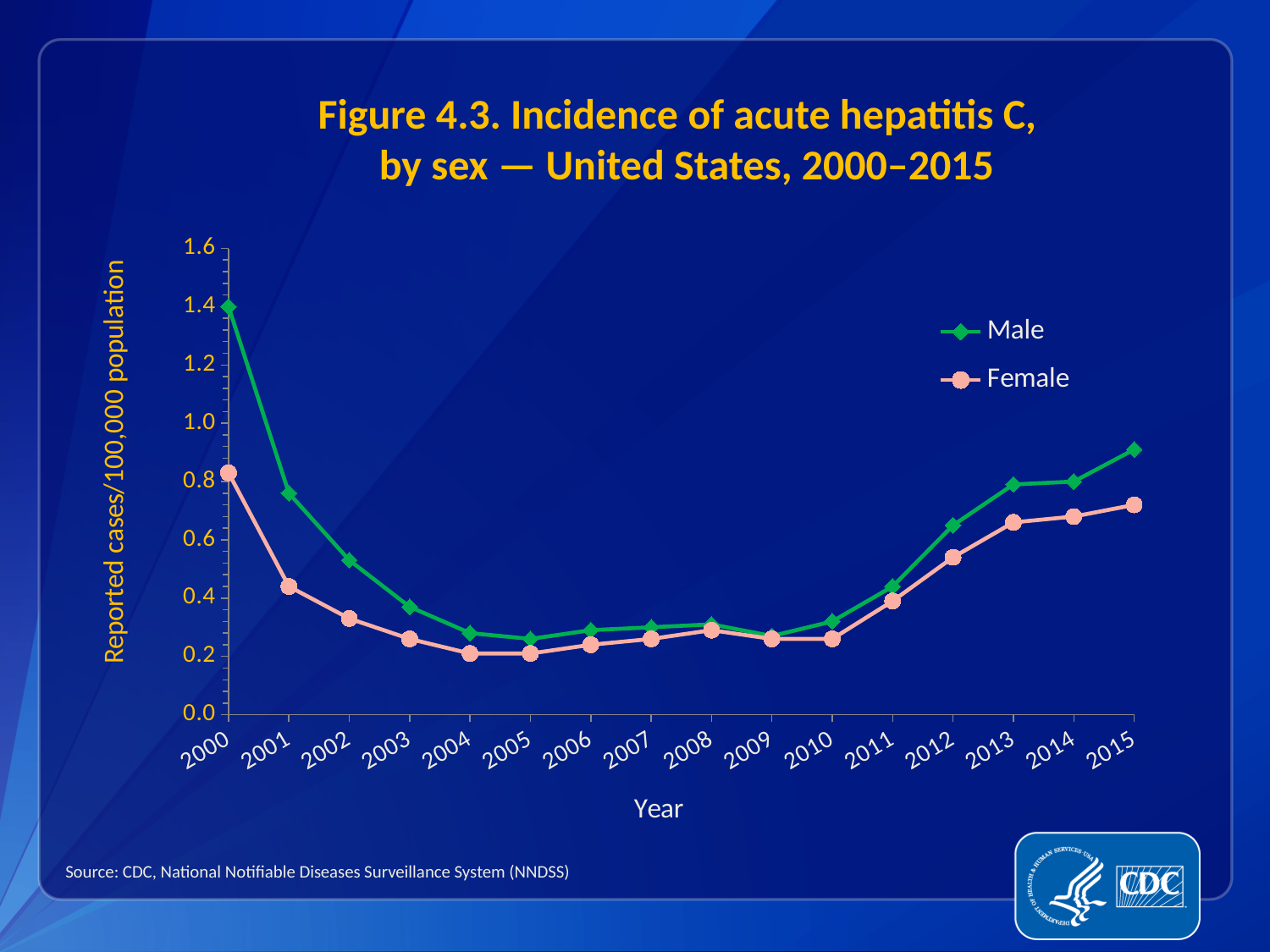
What is the label on the y axis? Reported cases/100,000 population Which series has the larger value in 2013, Male or Female? Male Do the Female values rise or fall from 2010 to 2015? Rise In which year is the Female incidence rate highest? 2000 How many years are plotted along the x axis? 16 Is the Female value for 2015 greater or less than 0.8? less How many series does the legend list? 2 Is the Male value for 2004 greater or less than 0.4? less In which year is the Male incidence rate highest? 2000 What kind of chart is shown on the slide? Line chart Do the Male values rise or fall from 2000 to 2004? Fall Is the Male value for 2000 greater or less than 1.2? greater